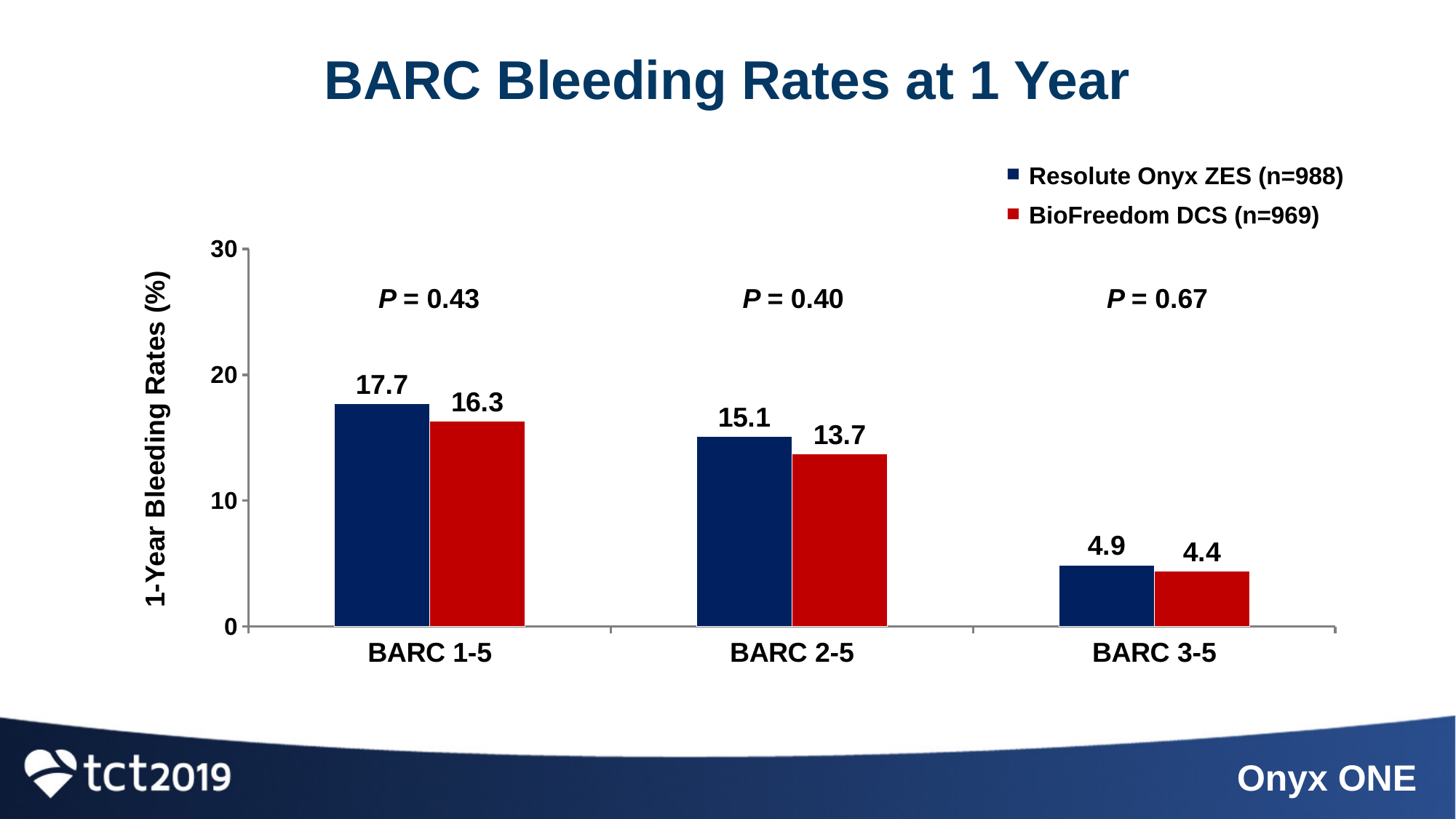
What is the 1-year bleeding rate for BioFreedom DCS in the BARC 3-5 category? 4.4 How many series does the legend list? 2 Which category has the lowest bleeding rate for BioFreedom DCS? BARC 3-5 In the BARC 1-5 category, which series has the higher bleeding rate, Resolute Onyx ZES or BioFreedom DCS? Resolute Onyx ZES What kind of chart is shown on the slide? Bar chart What is the P value shown above the BARC 2-5 category? P = 0.40 What is the 1-year bleeding rate for BioFreedom DCS in the BARC 2-5 category? 13.7 Which category has the highest bleeding rate for Resolute Onyx ZES? BARC 1-5 How many categories are shown on the x axis? 3 What is the 1-year bleeding rate for Resolute Onyx ZES in the BARC 1-5 category? 17.7 What is the difference between the Resolute Onyx ZES and BioFreedom DCS bleeding rates in the BARC 2-5 category? 1.4 Is the Resolute Onyx ZES bleeding rate for BARC 3-5 greater or less than 10? less